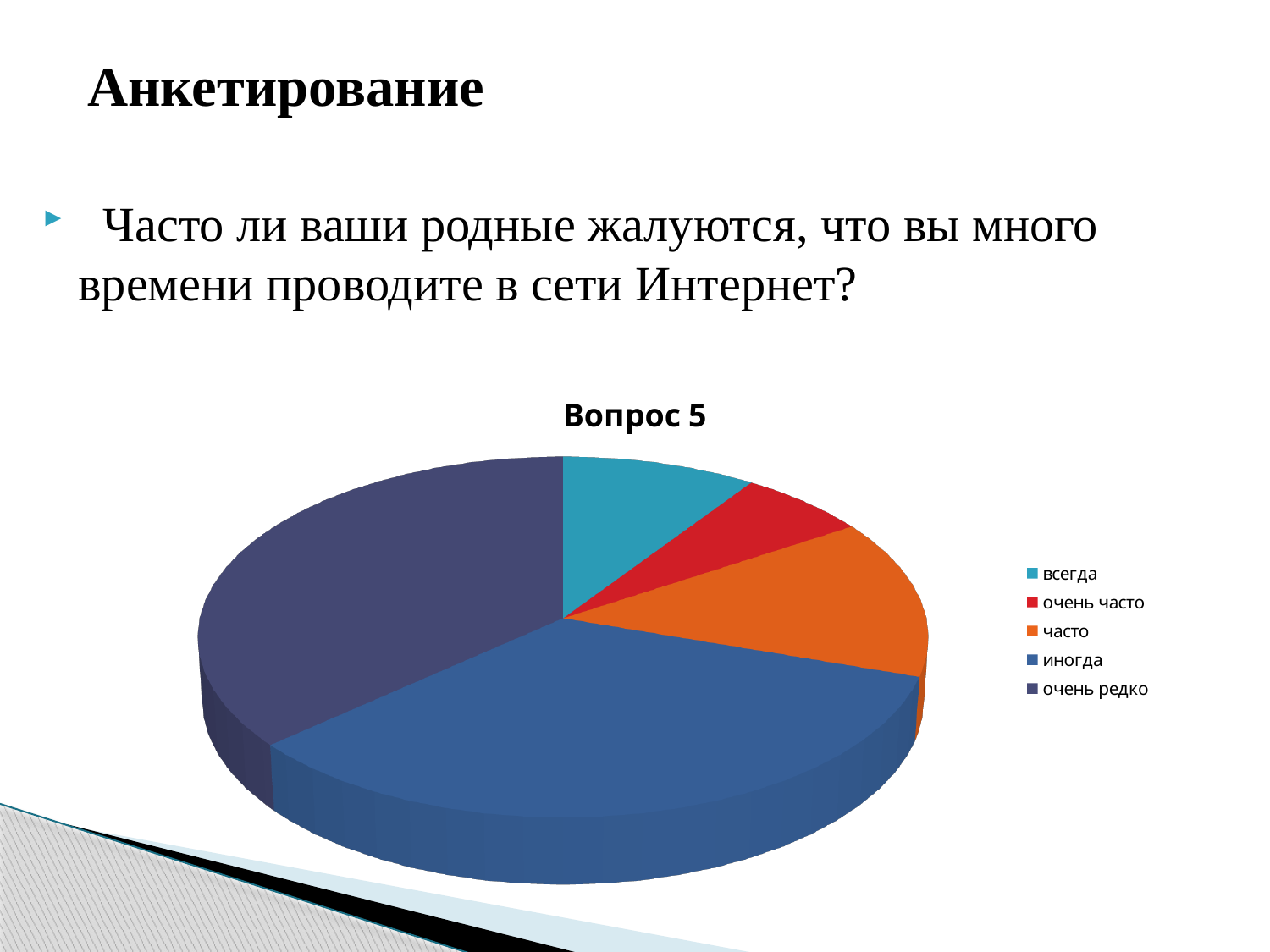
Which category has the smallest slice of the pie? очень часто How many categories (slices) does the pie chart have? 5 What kind of chart is shown on the slide? pie chart Which category is shown in orange in the pie chart? часто What is the title of the chart? Вопрос 5 Which slice is larger, иногда or всегда? иногда Which slice is larger, часто or очень часто? часто Which slice is larger, всегда or очень часто? всегда How many entries does the chart legend list? 5